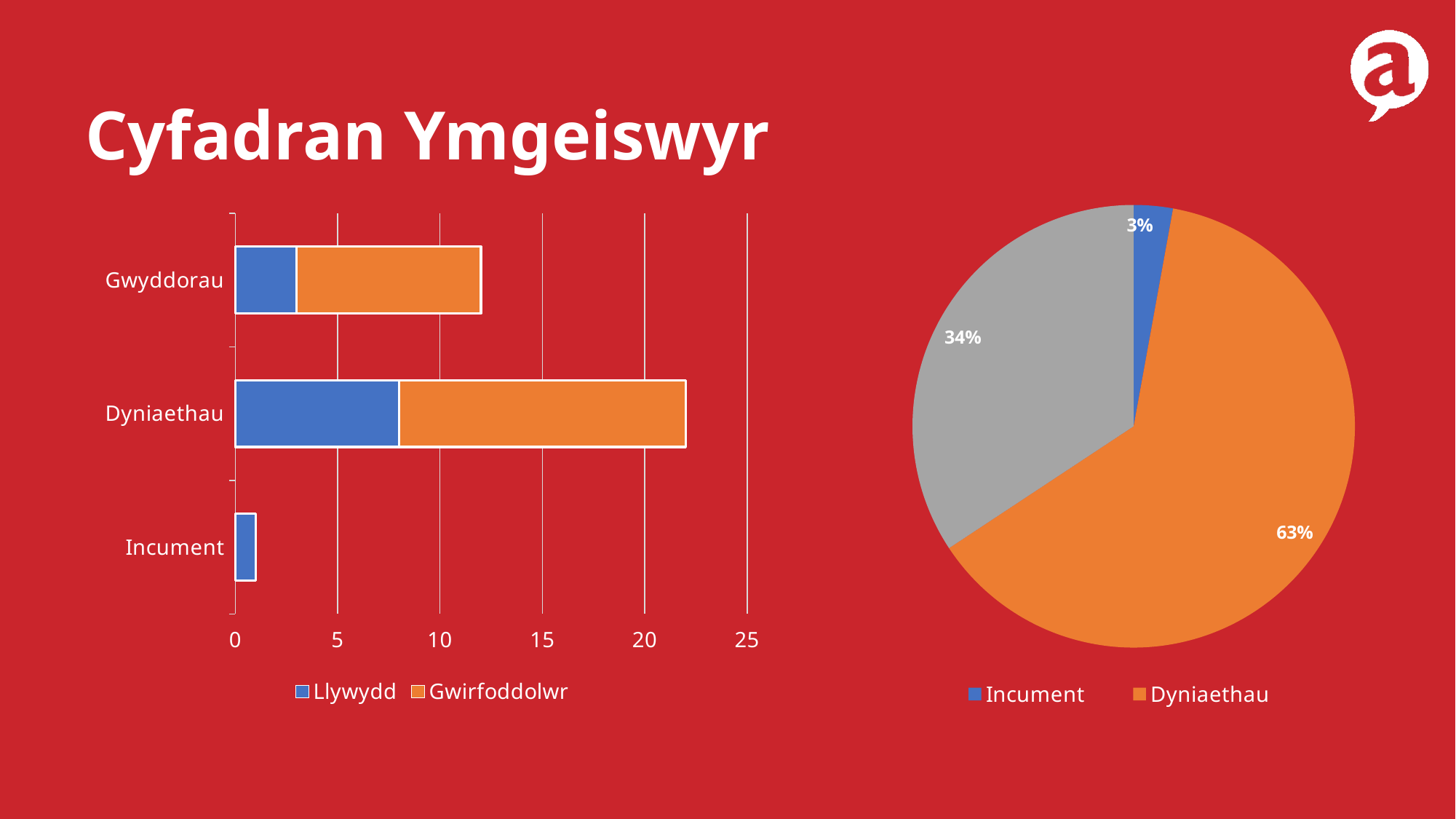
In the bar chart on the left, how many series does the legend list? 2 In the pie chart on the right, which of the two legend entries, Incument or Dyniaethau, has the larger slice? Dyniaethau What kind of chart is the chart on the right of the slide? pie chart In the bar chart on the left, is the total bar for Gwyddorau greater or less than 15? less In the pie chart on the right, what percentage is shown for Incument? 3% In the bar chart on the left, which category has the longest total bar? Dyniaethau What kind of chart is the chart on the left of the slide? bar chart In the bar chart on the left, is the Llywydd value for Dyniaethau greater or less than 5? greater In the bar chart on the left, how many categories are shown on the vertical axis? 3 In the bar chart on the left, which category has the shortest total bar? Incument In the bar chart on the left, is the total bar for Dyniaethau greater or less than 20? greater In the pie chart on the right, what percentage is shown for Dyniaethau? 63%